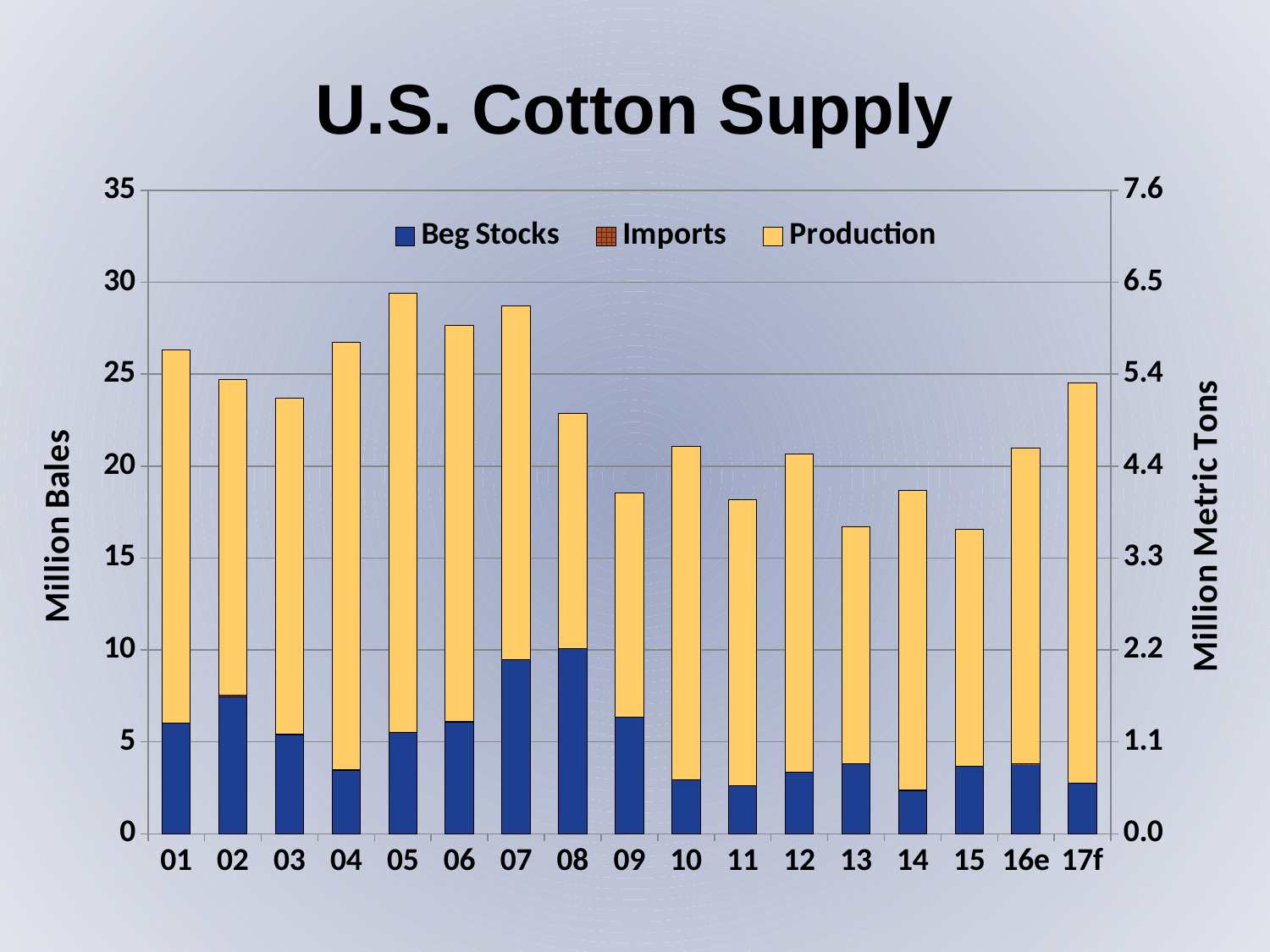
Is the total supply for 15 greater or less than 20 million bales? less Does the total supply rise or fall from 01 to 03? fall What is the label of the left vertical axis? Million Bales How many series does the legend list? 3 What is the title of the chart? U.S. Cotton Supply Is the Beg Stocks value for 08 greater or less than 5 million bales? greater Is the total supply for 05 greater or less than 25 million bales? greater What kind of chart is shown on the slide? Stacked bar chart Which year has the larger total supply, 01 or 02? 01 Which year has the larger Beg Stocks value, 08 or 04? 08 How many years (categories) are shown along the x axis? 17